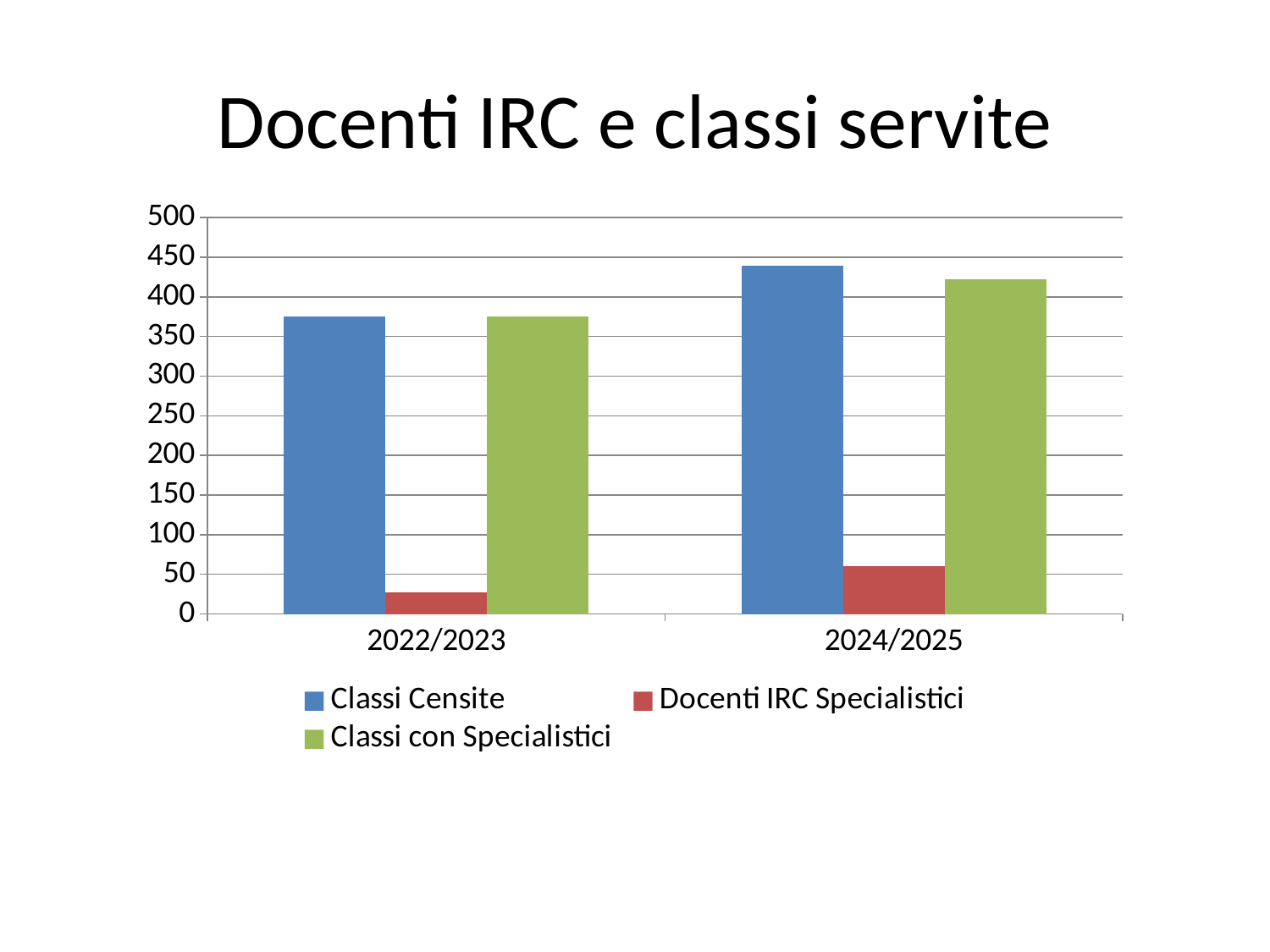
Does the value for Docenti IRC Specialistici rise or fall from 2022/2023 to 2024/2025? rise Is the value for Docenti IRC Specialistici in 2024/2025 greater or less than 100? less Which series has the lowest value in 2024/2025? Docenti IRC Specialistici Is the value for Classi con Specialistici in 2024/2025 greater or less than 400? greater Is the value for Docenti IRC Specialistici in 2022/2023 greater or less than 50? less How many categories are shown on the x axis? 2 How many series does the legend list? 3 What kind of chart is shown on the slide? bar chart What is the title of the chart? Docenti IRC e classi servite Which is larger: Classi Censite in 2024/2025 or Classi Censite in 2022/2023? Classi Censite in 2024/2025